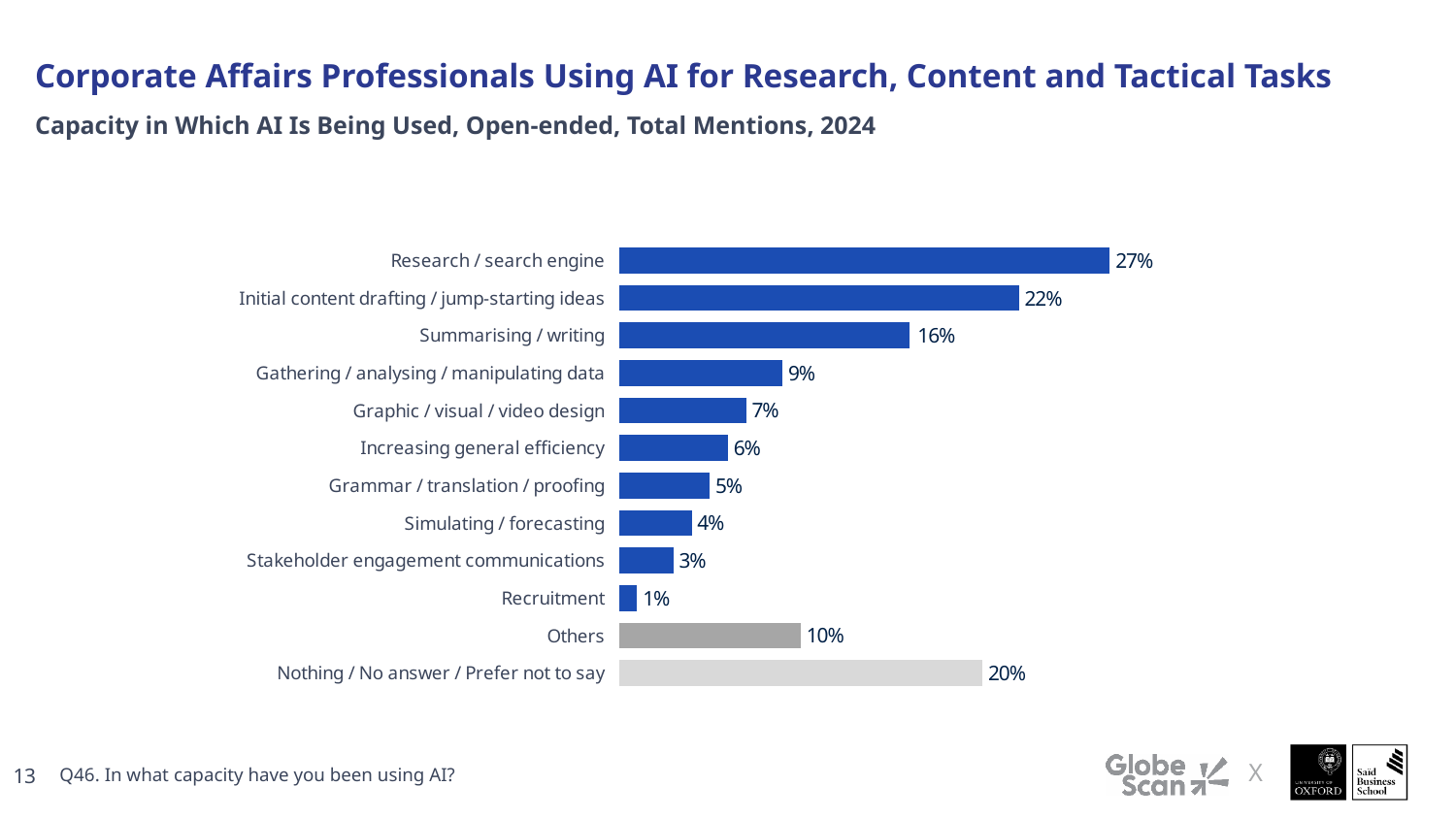
Which category has the lowest value on the chart? Recruitment What is the difference between Others and Gathering / analysing / manipulating data? 1% Which is larger, Increasing general efficiency or Simulating / forecasting? Increasing general efficiency What is the difference between Research / search engine and Summarising / writing? 11% What is the subtitle of the chart? Capacity in Which AI Is Being Used, Open-ended, Total Mentions, 2024 What percentage of mentions is shown for Research / search engine? 27% What is the value for Nothing / No answer / Prefer not to say? 20% What kind of chart is shown on the slide? Bar chart How many categories are shown on the chart? 12 What is the value for Initial content drafting / jump-starting ideas? 22% Which category has the highest value on the chart? Research / search engine What percentage is shown for Graphic / visual / video design? 7%